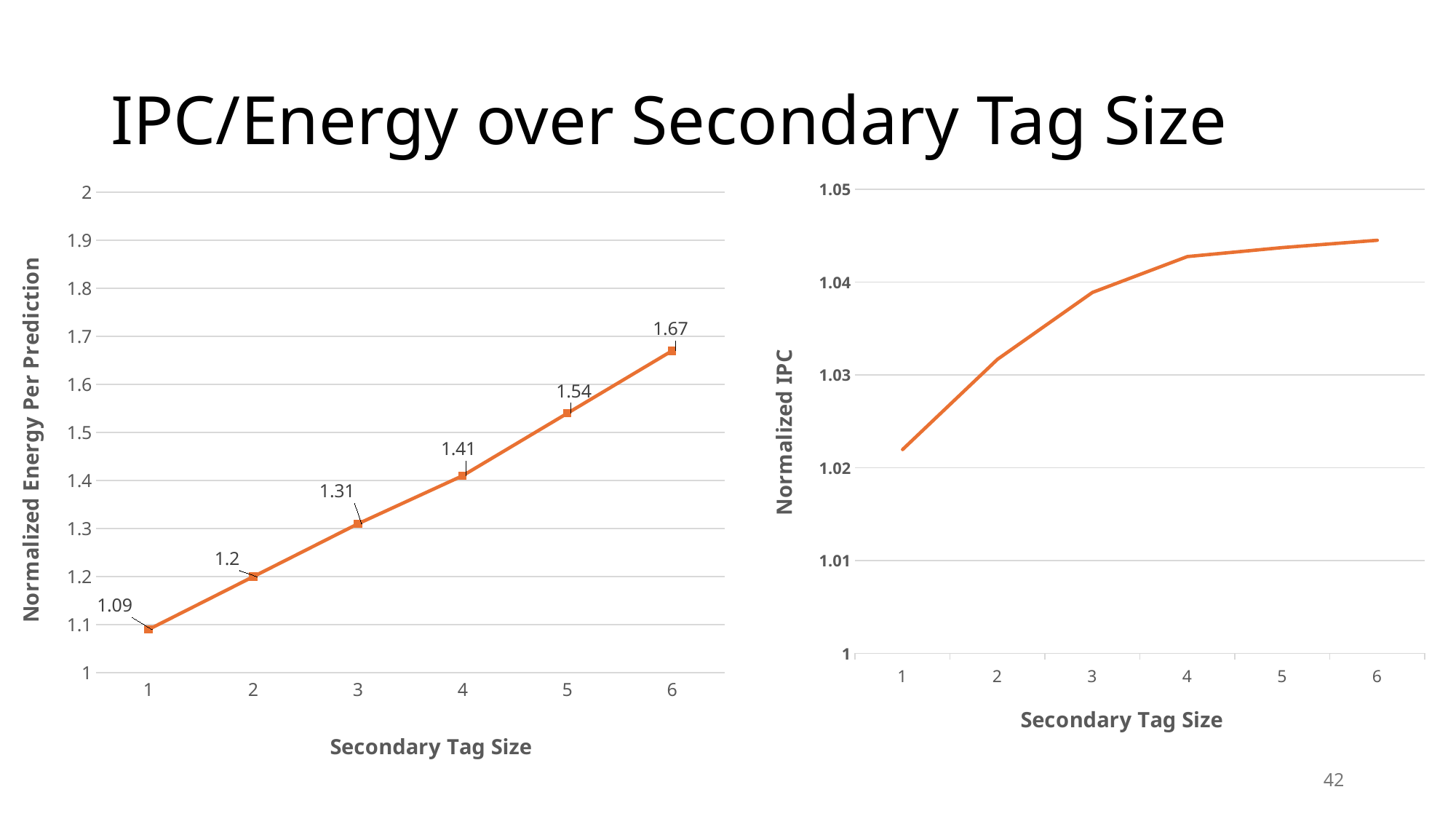
What kind of chart is the right chart (Normalized IPC)? line chart In the left chart (Normalized Energy Per Prediction), how many data points are plotted? 6 In the right chart (Normalized IPC), which secondary tag size has the lowest value? 1 In the right chart (Normalized IPC), is the value at secondary tag size 4 greater or less than 1.04? greater In the left chart (Normalized Energy Per Prediction), which secondary tag size has the lowest value? 1 In the left chart (Normalized Energy Per Prediction), what is the value at secondary tag size 1? 1.09 In the left chart (Normalized Energy Per Prediction), which secondary tag size has the highest value? 6 In the left chart (Normalized Energy Per Prediction), what is the value at secondary tag size 3? 1.31 In the left chart (Normalized Energy Per Prediction), what is the value at secondary tag size 6? 1.67 In the left chart (Normalized Energy Per Prediction), what is the difference between the values at secondary tag size 6 and secondary tag size 1? 0.58 In the right chart (Normalized IPC), is the value at secondary tag size 6 greater or less than 1.05? less In the left chart (Normalized Energy Per Prediction), do the values rise or fall as secondary tag size increases? rise